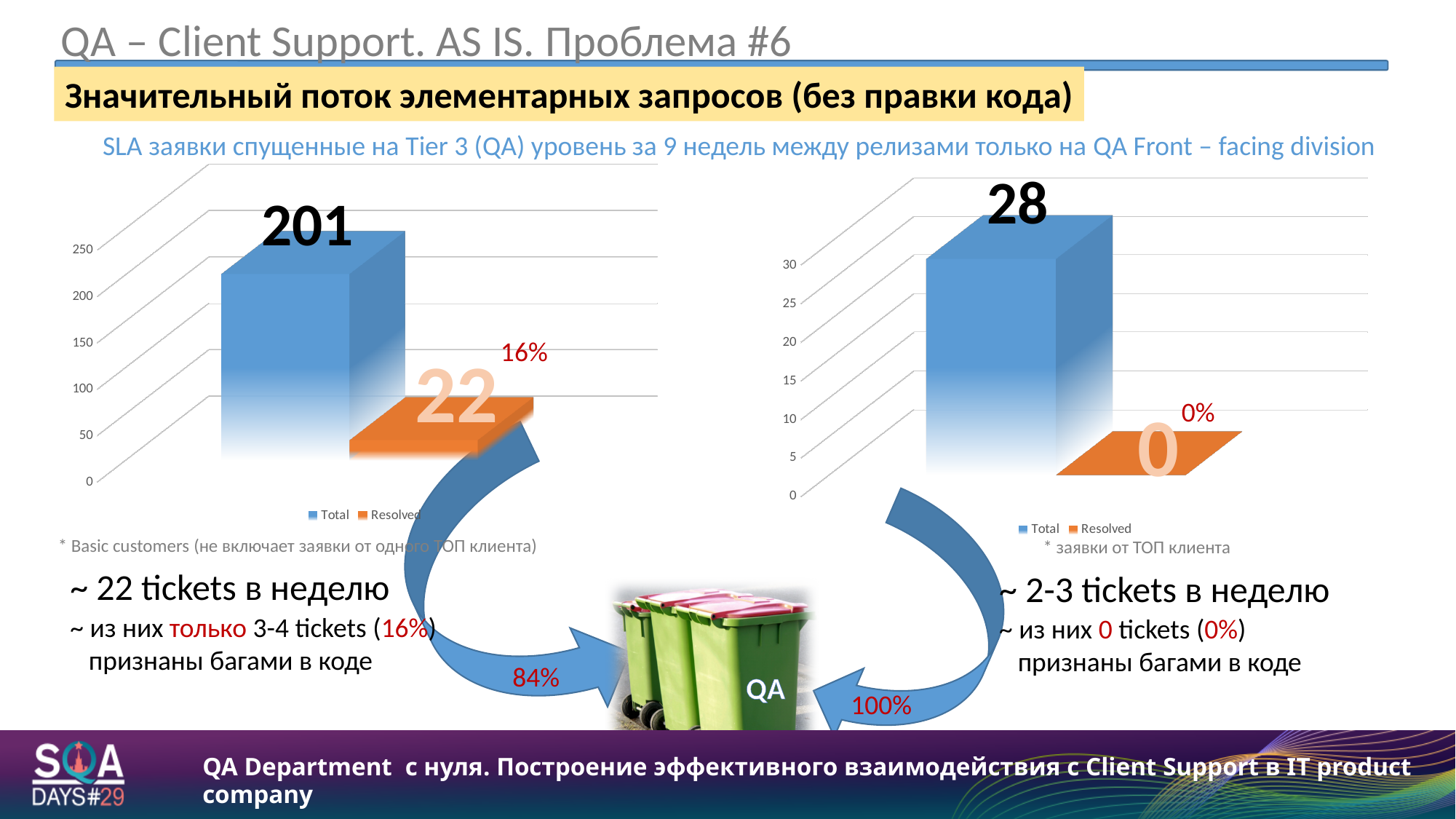
What colour is the Resolved series in the legend of the right chart? Orange In the right chart, what is the difference between the Total and Resolved values? 28 What type of chart is the right chart? Bar chart In the right chart, which series has the smaller value? Resolved In the left chart, is the value for Total greater or less than 200? greater In the left chart, what is the difference between the Total and Resolved values? 179 In the left chart, what is the value of the Total bar? 201 In the right chart, what is the value of the Resolved bar? 0 In the left chart, which series has the larger value, Total or Resolved? Total How many series does the legend of the left chart list? 2 In the left chart, what is the value of the Resolved bar? 22 In the right chart, what is the value of the Total bar? 28